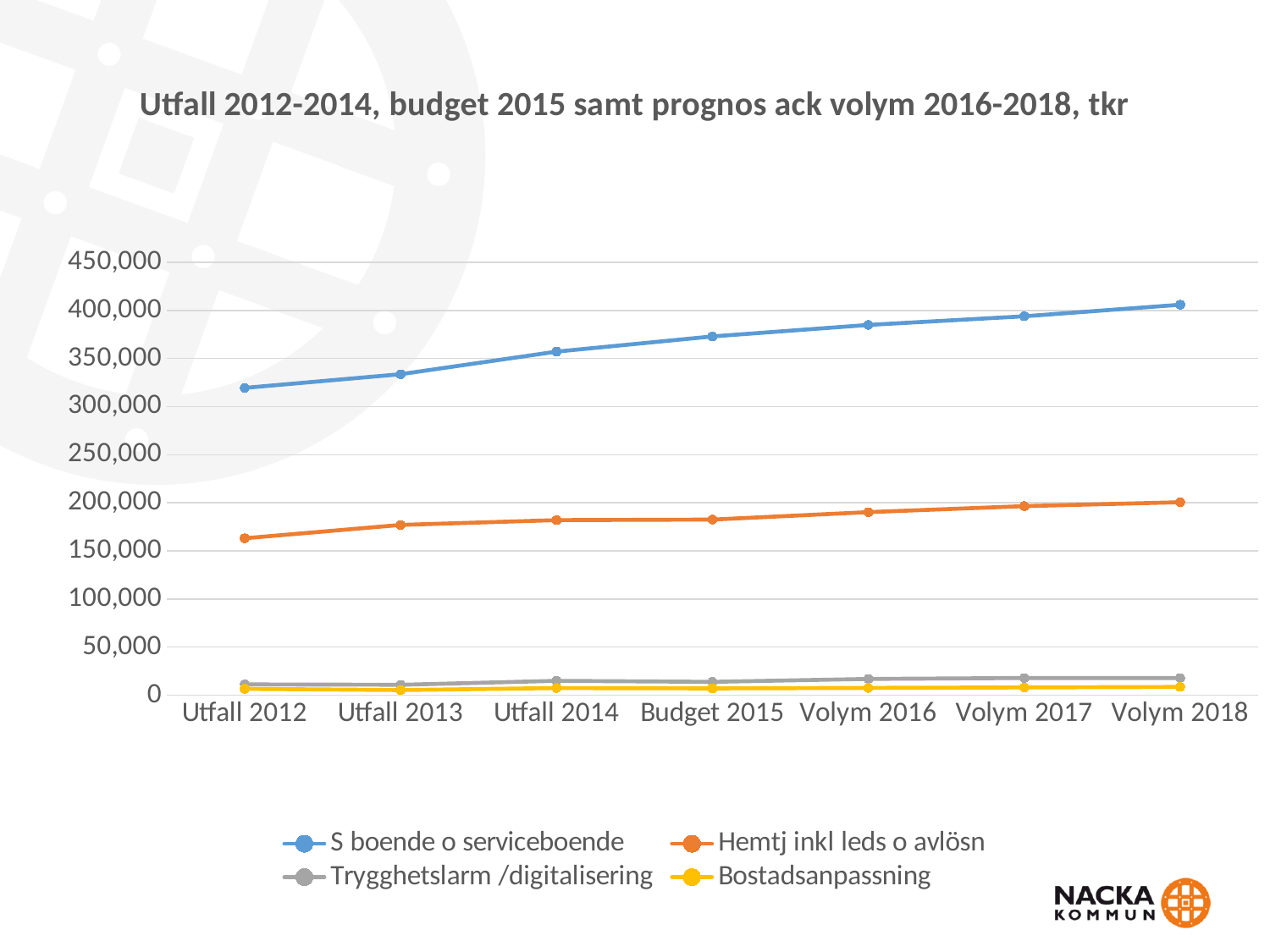
How many series does the legend list? 4 Is the value for S boende o serviceboende at Budget 2015 greater or less than 350,000? greater Which series has the lowest value at Utfall 2012? Bostadsanpassning Is the value for S boende o serviceboende at Utfall 2012 greater or less than 300,000? greater What kind of chart is shown on the slide? line chart Is the value for Trygghetslarm /digitalisering at Volym 2017 greater or less than 50,000? less How many categories are shown along the x axis? 7 Which is larger at Utfall 2013: S boende o serviceboende or Hemtj inkl leds o avlösn? S boende o serviceboende Which series has the highest value at Volym 2018? S boende o serviceboende Do the values for S boende o serviceboende rise or fall from Utfall 2012 to Volym 2018? rise What is the title of the chart? Utfall 2012-2014, budget 2015 samt prognos ack volym 2016-2018, tkr